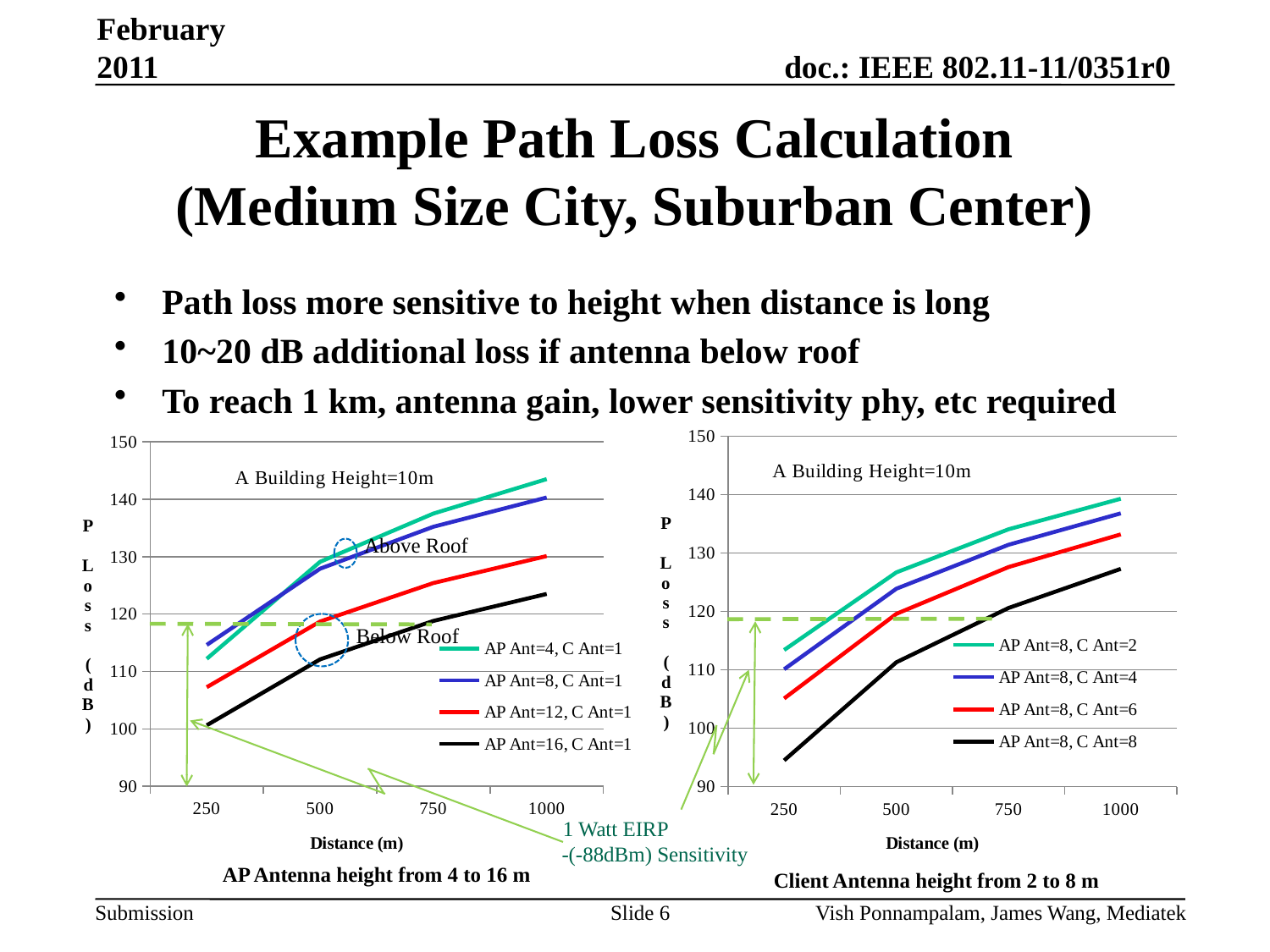
What is the x-axis label of the right chart (Client Antenna height from 2 to 8 m)? Distance (m) In the right chart (Client Antenna height from 2 to 8 m), which is larger at 1000 m: the path loss for AP Ant=8, C Ant=2 or for AP Ant=8, C Ant=6? AP Ant=8, C Ant=2 In the right chart (Client Antenna height from 2 to 8 m), is the path loss for AP Ant=8, C Ant=8 at 250 m greater or less than 100? less In the left chart (AP Antenna height from 4 to 16 m), is the path loss for AP Ant=4, C Ant=1 at 1000 m greater or less than 140? greater In the left chart (AP Antenna height from 4 to 16 m), does the path loss rise or fall as distance increases? rise In the left chart (AP Antenna height from 4 to 16 m), which series has the highest path loss at 1000 m? AP Ant=4, C Ant=1 In the right chart (Client Antenna height from 2 to 8 m), is the path loss for AP Ant=8, C Ant=8 at 1000 m greater or less than 130? less What kind of chart is the left chart (AP Antenna height from 4 to 16 m)? line chart How many distance points are shown on the x axis of the left chart (AP Antenna height from 4 to 16 m)? 4 How many series does the legend of the right chart (Client Antenna height from 2 to 8 m) list? 4 In the right chart (Client Antenna height from 2 to 8 m), which series has the lowest path loss at 250 m? AP Ant=8, C Ant=8